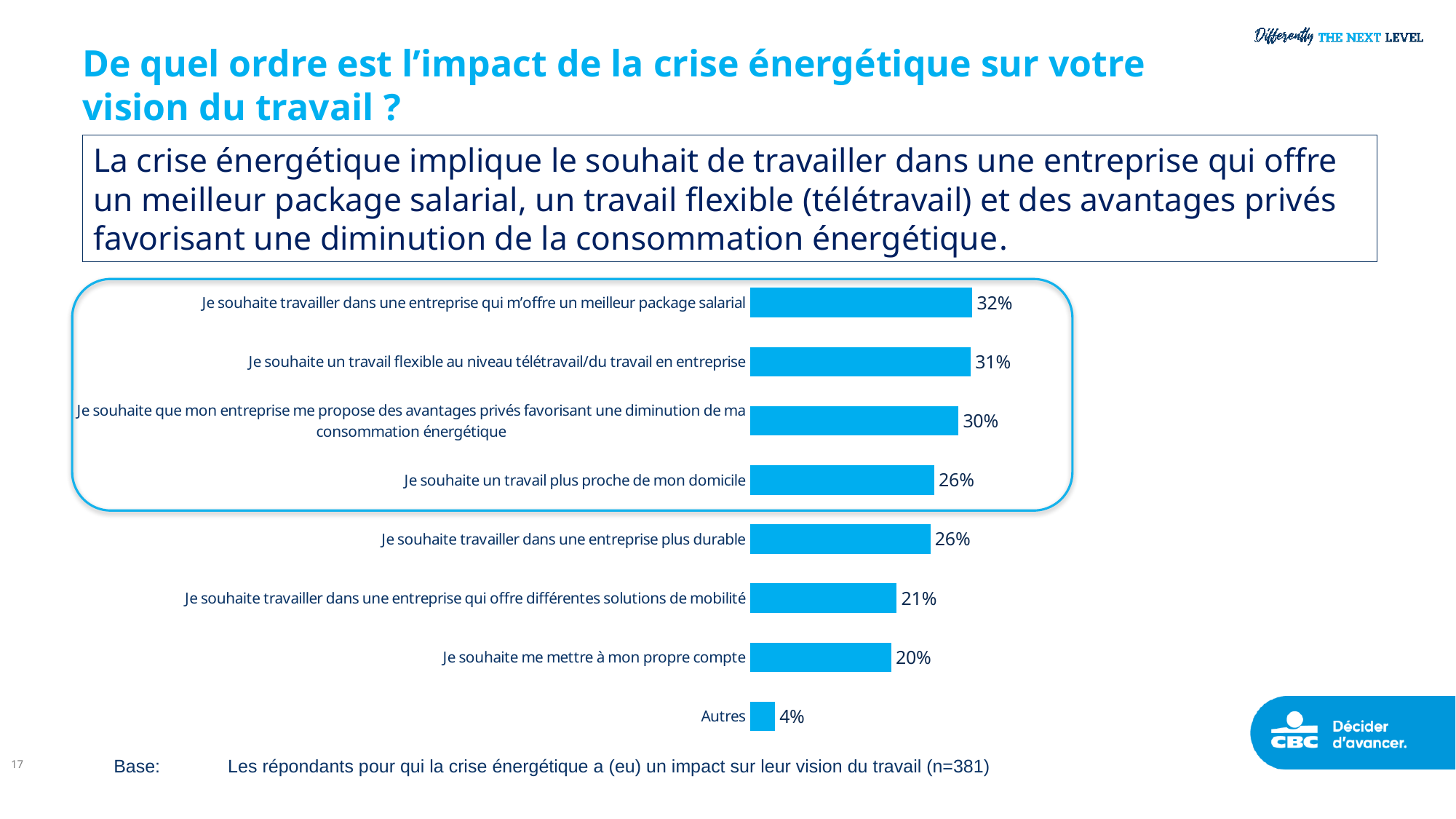
Which category has the lowest value? Autres Which is larger: the value for "Je souhaite travailler dans une entreprise plus durable" or the value for "Je souhaite me mettre à mon propre compte"? Je souhaite travailler dans une entreprise plus durable What is the value for "Autres"? 4% What is the value for "Je souhaite me mettre à mon propre compte"? 20% Which category has the highest value? Je souhaite travailler dans une entreprise qui m'offre un meilleur package salarial What is the difference between the value for "Je souhaite un travail plus proche de mon domicile" and the value for "Je souhaite me mettre à mon propre compte"? 6% What is the difference between the value for "Je souhaite travailler dans une entreprise qui offre différentes solutions de mobilité" and the value for "Autres"? 17% How many categories are shown in the chart? 8 What is the value for "Je souhaite travailler dans une entreprise qui m'offre un meilleur package salarial"? 32% What is the sample size (n) given in the base note below the chart? 381 What is the value for "Je souhaite un travail flexible au niveau télétravail/du travail en entreprise"? 31% What kind of chart is shown on the slide? Bar chart